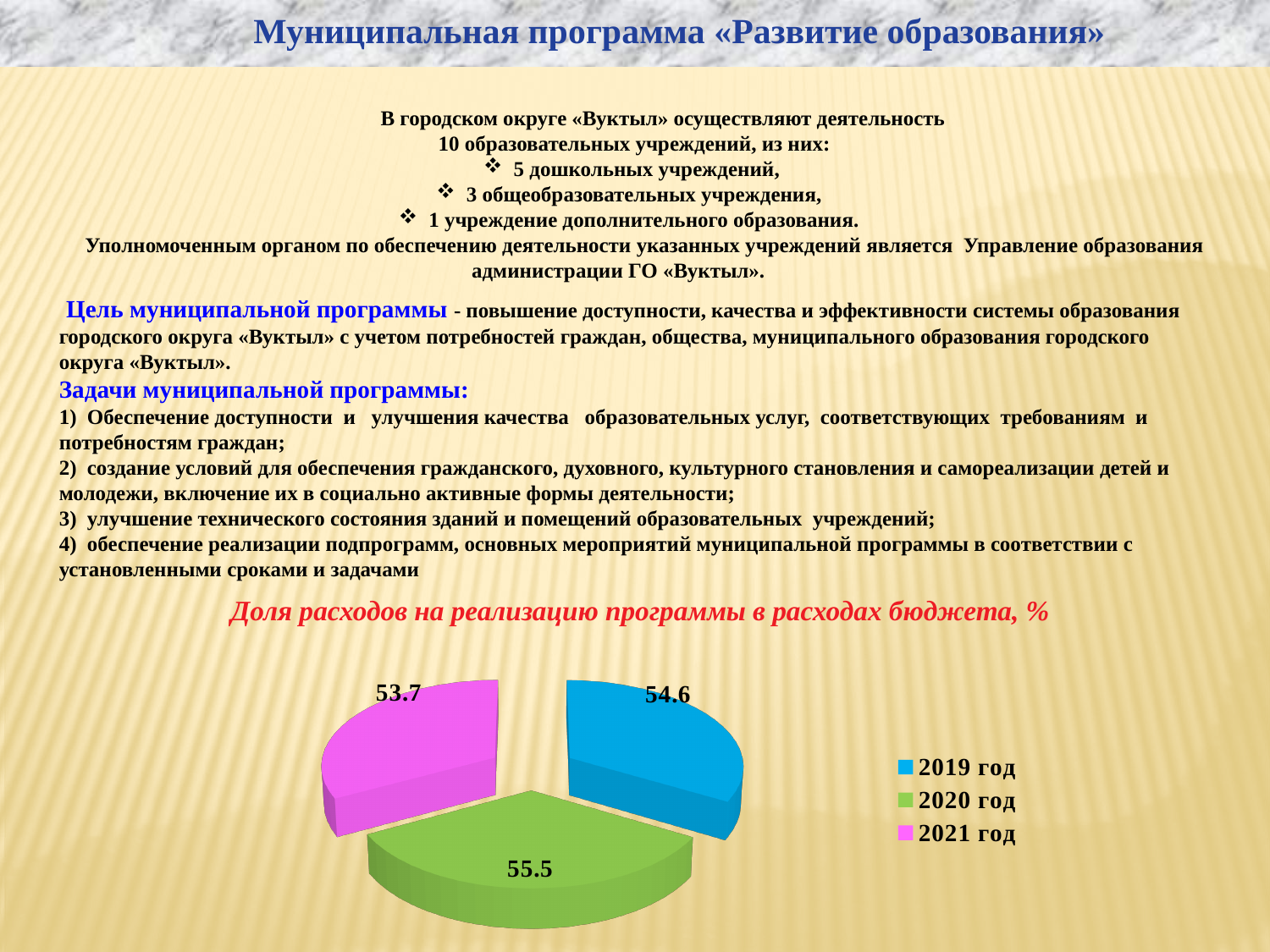
Which year has the highest value in the pie chart? 2020 год What is the difference between the values for 2019 год and 2021 год? 0.9 How many slices does the pie chart have? 3 What is the title of the chart? Доля расходов на реализацию программы в расходах бюджета, % What is the value for 2020 год in the pie chart? 55.5 What is the value for 2019 год in the pie chart? 54.6 Which is larger, the value for 2020 год or the value for 2021 год? 2020 год Which year has the lowest value in the pie chart? 2021 год What type of chart is shown on the slide? pie chart What colour is the slice for 2021 год? pink What is the difference between the values for 2020 год and 2019 год? 0.9 What is the value for 2021 год in the pie chart? 53.7